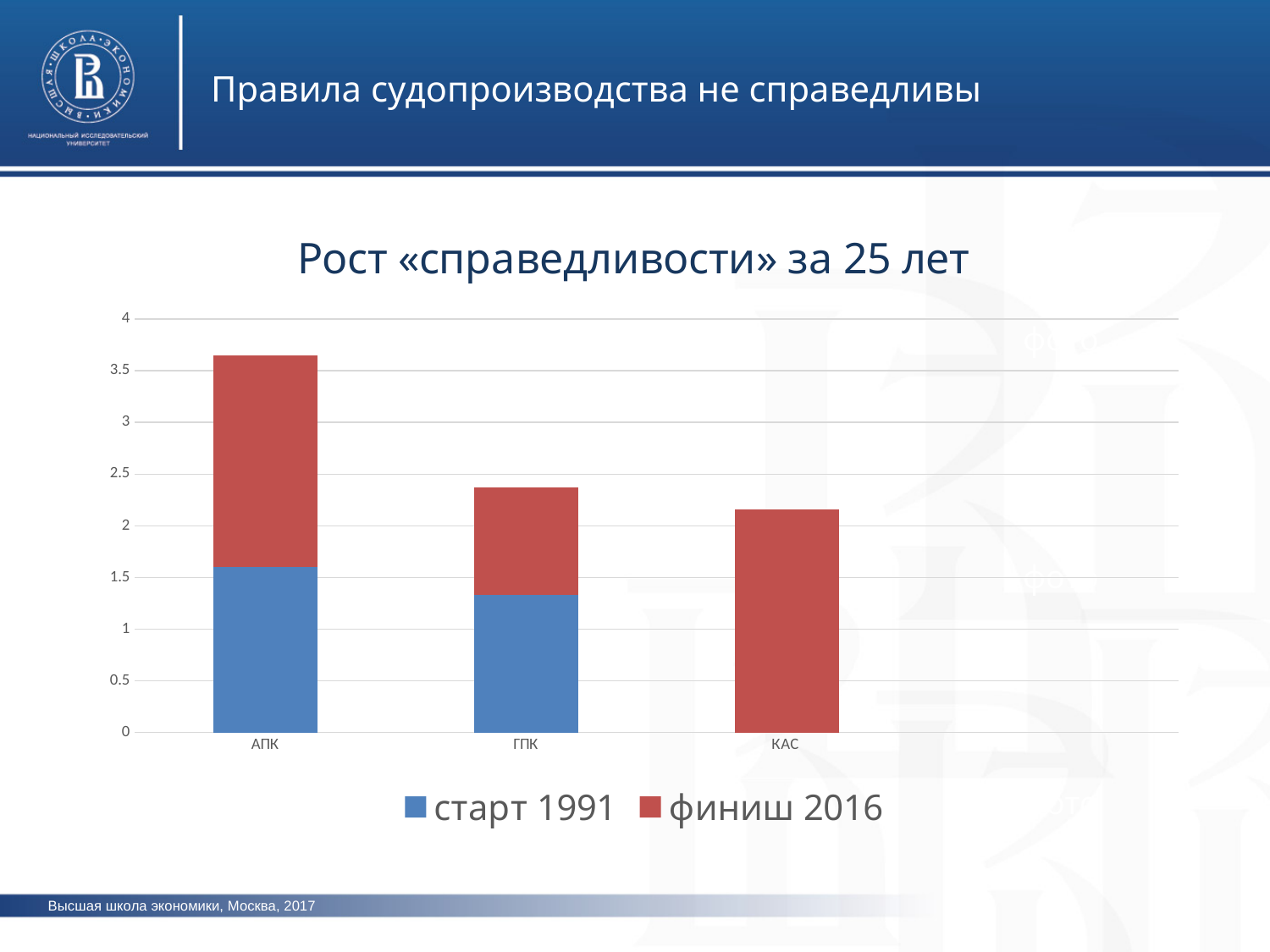
How many categories are shown on the x axis of the chart? 3 Is the total height of the АПК bar greater or less than 3.5? greater Which category has the tallest stacked bar in the chart? АПК Which series is shown in blue in the chart? старт 1991 Which category has the shortest stacked bar in the chart? КАС How many series does the chart legend list? 2 What is the title of the chart? Рост «справедливости» за 25 лет Is the total height of the ГПК bar greater or less than 2.5? less Which stacked bar is taller, ГПК or КАС? ГПК What kind of chart is shown on the slide? bar chart Is the старт 1991 value for ГПК greater or less than 1.5? less